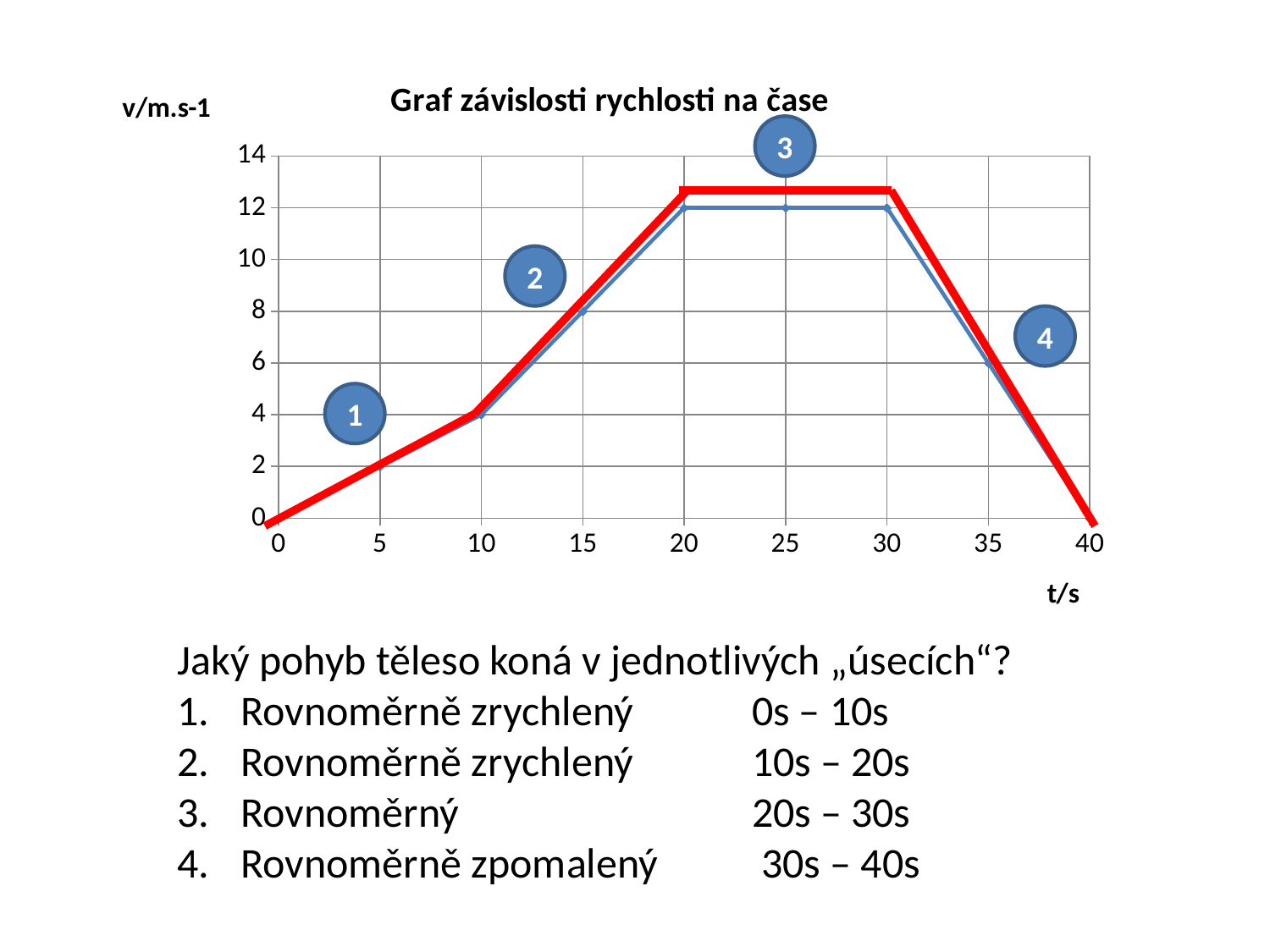
Is the velocity value at t = 35 s greater or less than 8? less Which is larger, the velocity at t = 15 s or at t = 35 s? t = 15 s What label is shown on the horizontal axis of the chart? t/s What is the highest velocity value reached on the chart? 12 What is the title of the chart? Graf závislosti rychlosti na čase What is the velocity value at t = 10 s? 4 What kind of chart is shown on the slide? line chart What is the velocity value at t = 20 s? 12 Does the velocity rise or fall between t = 30 s and t = 40 s? fall Is the velocity value at t = 15 s greater or less than 6? greater What is the velocity value at t = 40 s? 0 Does the velocity rise or fall between t = 0 s and t = 20 s? rise